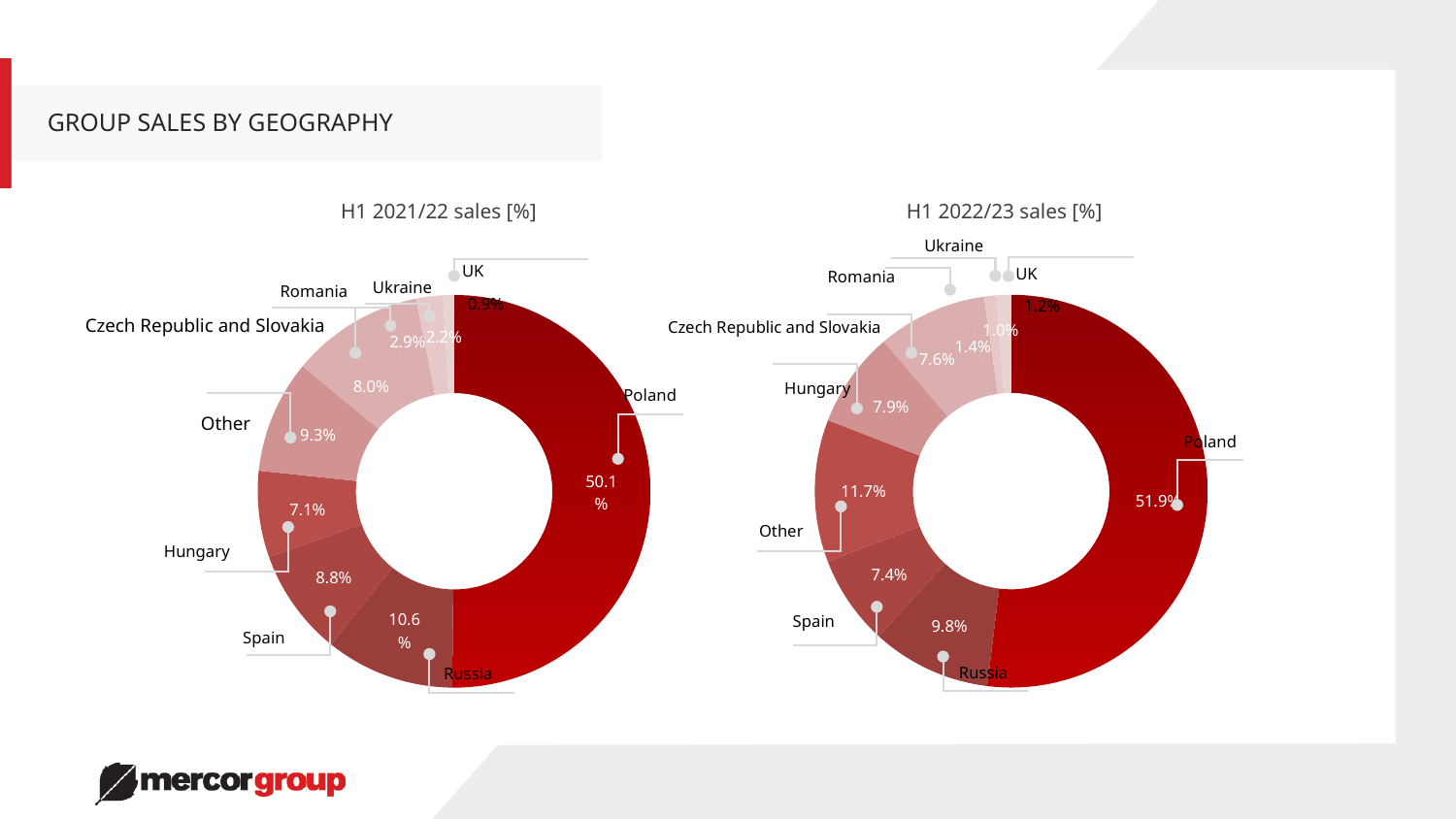
In the H1 2022/23 sales chart, what is the value for Other? 11.7% In the H1 2021/22 sales chart, which category has the smallest share? UK In the H1 2021/22 sales chart, what is the value for Russia? 10.6% In the H1 2021/22 sales chart, what share does Poland have? 50.1% What type of chart is used for the H1 2022/23 sales? Donut (pie) chart In the H1 2022/23 sales chart, what is the difference between Russia and Spain? 2.4% In the H1 2022/23 sales chart, which category has the largest share? Poland In the H1 2021/22 sales chart, which is larger: Spain or Hungary? Spain In the H1 2022/23 sales chart, what share does Poland have? 51.9% In the H1 2022/23 sales chart, which category has the smallest share? Ukraine How many categories are shown in the H1 2021/22 sales chart? 9 What is the difference between Poland's share in H1 2022/23 and in H1 2021/22? 1.8%